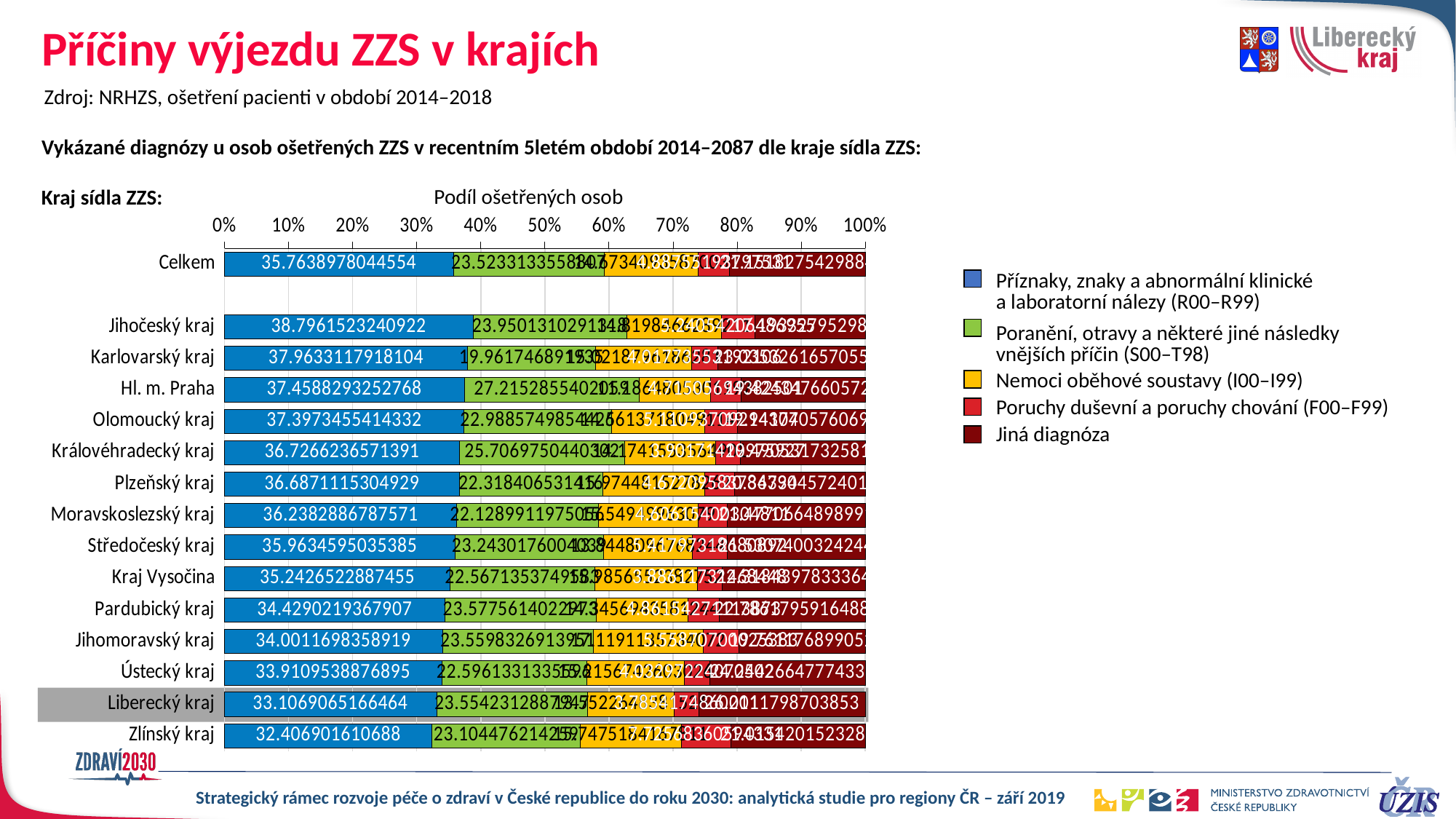
Is the 'Příznaky, znaky a abnormální klinické a laboratorní nálezy (R00–R99)' value for Zlínský kraj greater or less than 30%? greater What is the value of the 'Příznaky, znaky a abnormální klinické a laboratorní nálezy (R00–R99)' segment for Celkem? 35.7638978044554 Which has a larger 'Příznaky, znaky a abnormální klinické a laboratorní nálezy (R00–R99)' value: Karlovarský kraj or Ústecký kraj? Karlovarský kraj What is the value of the 'Příznaky, znaky a abnormální klinické a laboratorní nálezy (R00–R99)' segment for Hl. m. Praha? 37.4588293252768 How many series does the legend list? 5 What is the value of the 'Příznaky, znaky a abnormální klinické a laboratorní nálezy (R00–R99)' segment for Zlínský kraj? 32.406901610688 What is the difference between the 'Příznaky, znaky a abnormální klinické a laboratorní nálezy (R00–R99)' values for Jihočeský kraj and Zlínský kraj? 6.3892507134042 Which region has the highest value for the 'Příznaky, znaky a abnormální klinické a laboratorní nálezy (R00–R99)' series? Jihočeský kraj How many bars (rows) are plotted in the chart, including Celkem? 15 What kind of chart is shown on the slide? Stacked bar chart Which region has the lowest value for the 'Příznaky, znaky a abnormální klinické a laboratorní nálezy (R00–R99)' series? Zlínský kraj What is the value of the 'Příznaky, znaky a abnormální klinické a laboratorní nálezy (R00–R99)' segment for Liberecký kraj? 33.1069065166464